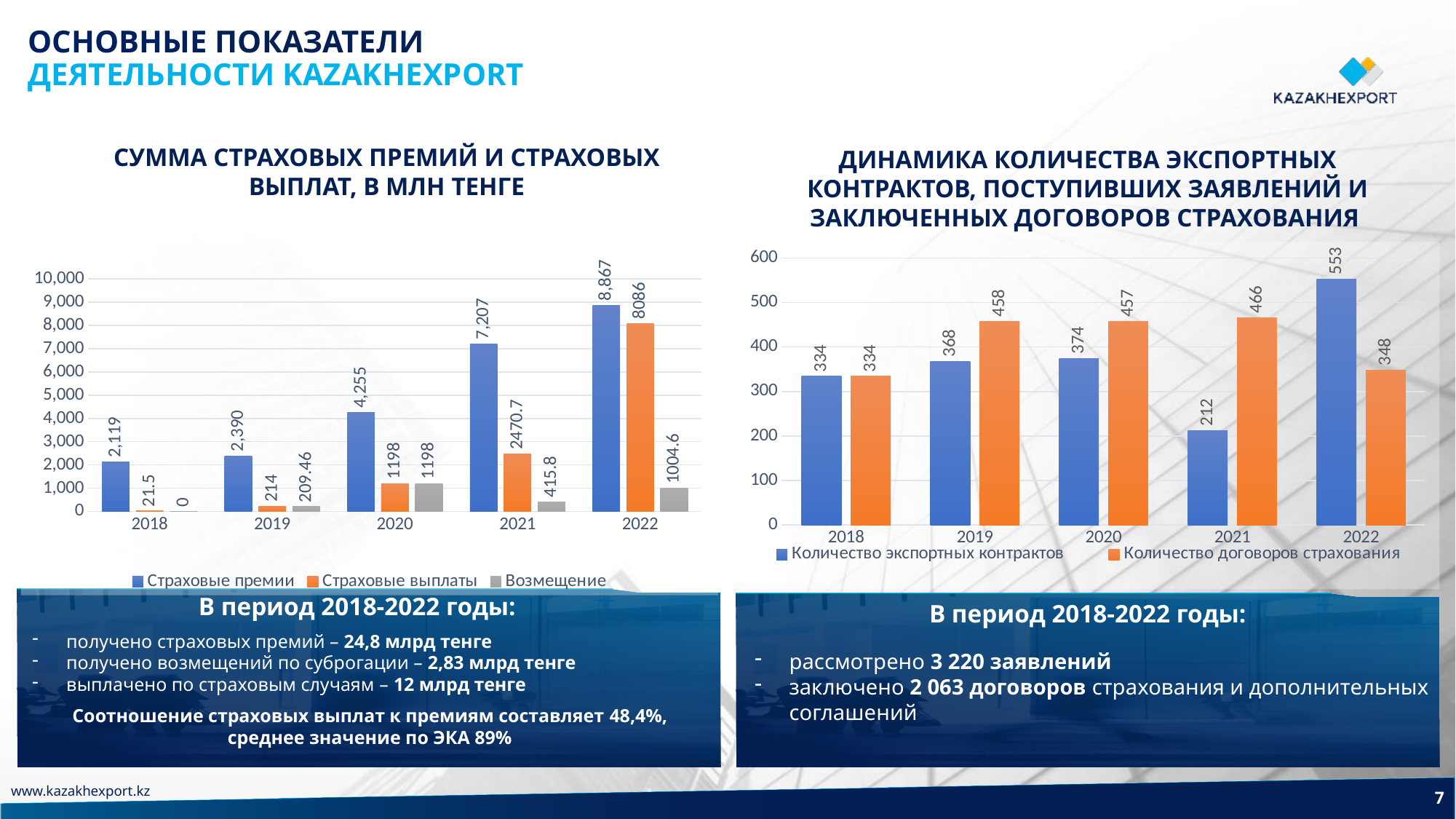
In the right chart, which is larger in 2019: Количество экспортных контрактов or Количество договоров страхования? Количество договоров страхования What type of chart is the right chart? bar chart In the left chart, what is the value of Возмещение for 2019? 209.46 In the right chart, what is the difference between Количество экспортных контрактов and Количество договоров страхования in 2022? 205 In the right chart (export contracts and insurance agreements), what is the value of Количество экспортных контрактов for 2021? 212 In the left chart, what is the difference between Страховые премии and Страховые выплаты in 2022? 781 In the left chart, do the values for Страховые премии rise or fall from 2018 to 2022? rise In the left chart, what is the value of Страховые выплаты for 2021? 2470.7 In the right chart, which year has the highest value for Количество экспортных контрактов? 2022 In the left chart, how many series does the legend list? 3 In the left chart, which year has the lowest value for Страховые премии? 2018 In the left chart (insurance premiums and payouts), what is the value of Страховые премии for 2022? 8,867